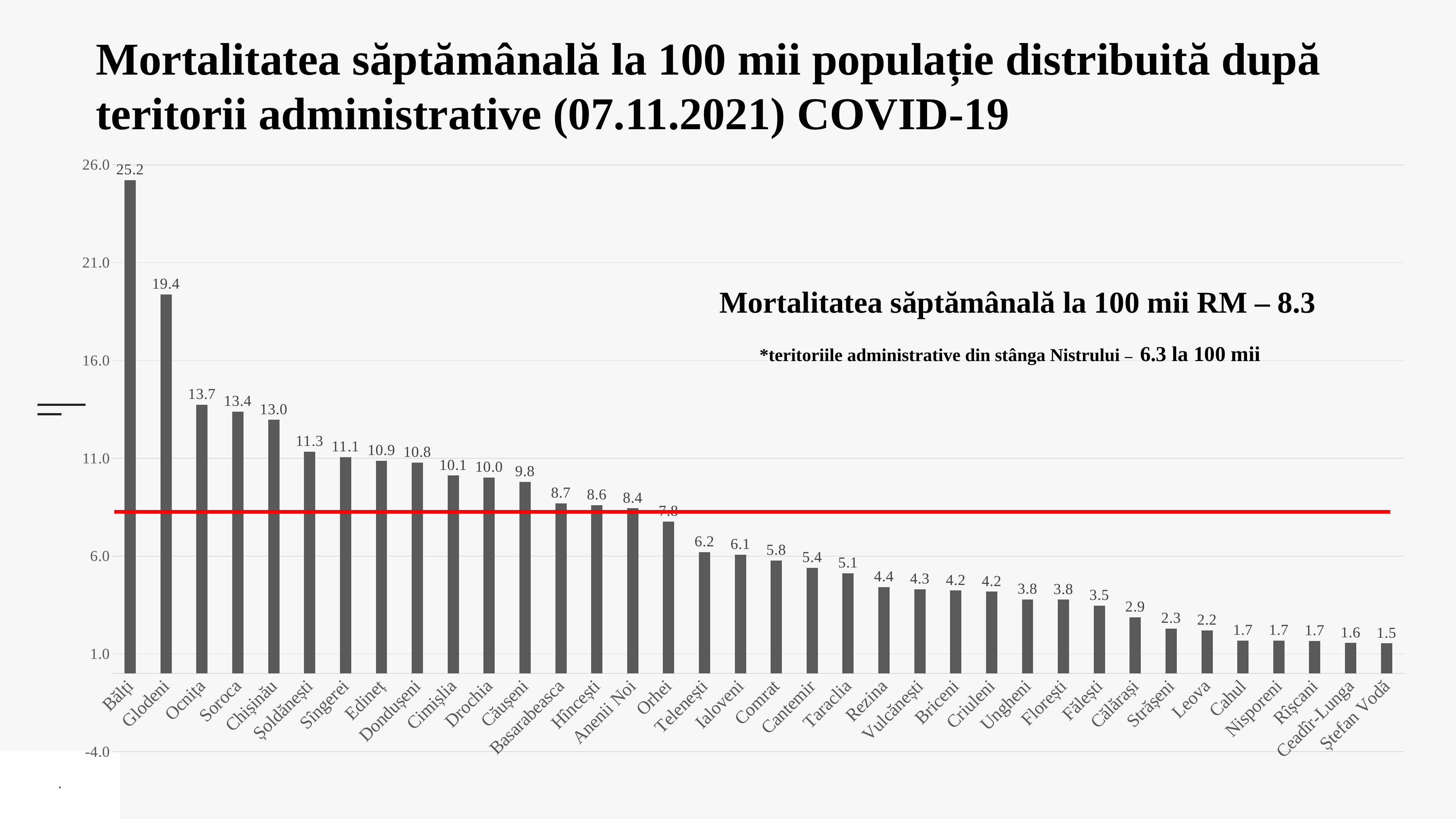
Which has a larger value, Soroca or Telenești? Soroca What kind of chart is shown on the slide? Bar chart Which territory has the highest value? Bălți What is the value for Orhei? 7.8 How many territories are shown on the x axis? 36 What is the difference between the values for Bălți and Glodeni? 5.8 Which territory has the lowest value? Ștefan Vodă What weekly mortality per 100 thousand for RM is stated in the text on the chart? 8.3 What is the value for Cahul? 1.7 Do the values rise or fall from left to right along the x axis? Fall What is the value for Chișinău? 13.0 What is the value for Bălți? 25.2